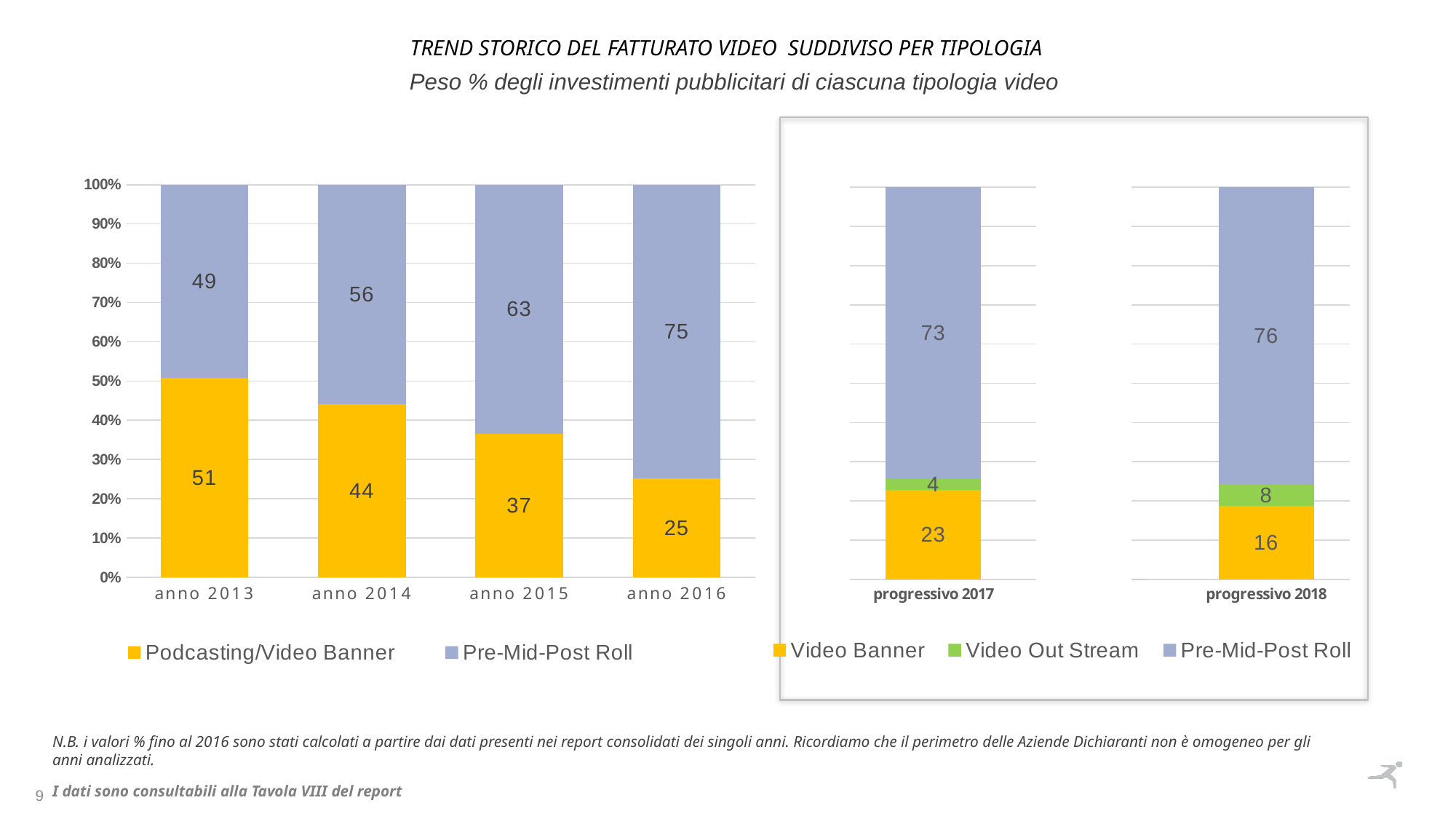
In the left chart (anno 2013–2016), which year has the lowest value for Pre-Mid-Post Roll? anno 2013 In the left chart (anno 2013–2016), which year has the highest value for Podcasting/Video Banner? anno 2013 What kind of chart is the left chart (anno 2013–2016)? stacked bar chart In the right chart (progressivo 2017–2018), what is the value for Video Banner in progressivo 2017? 23 In the left chart (anno 2013–2016), what is the difference between the Pre-Mid-Post Roll values for anno 2016 and anno 2013? 26 In the left chart (anno 2013–2016), what is the value for Pre-Mid-Post Roll in anno 2015? 63 In the right chart (progressivo 2017–2018), what is the value for Video Out Stream in progressivo 2018? 8 In the left chart (anno 2013–2016), does the Podcasting/Video Banner value rise or fall from anno 2013 to anno 2016? fall How many years are shown on the x axis of the left chart (anno 2013–2016)? 4 How many series does the legend of the right chart (progressivo 2017–2018) list? 3 In the right chart (progressivo 2017–2018), which is larger: Video Banner in progressivo 2017 or Video Banner in progressivo 2018? progressivo 2017 In the left chart (anno 2013–2016), what is the value for Podcasting/Video Banner in anno 2014? 44